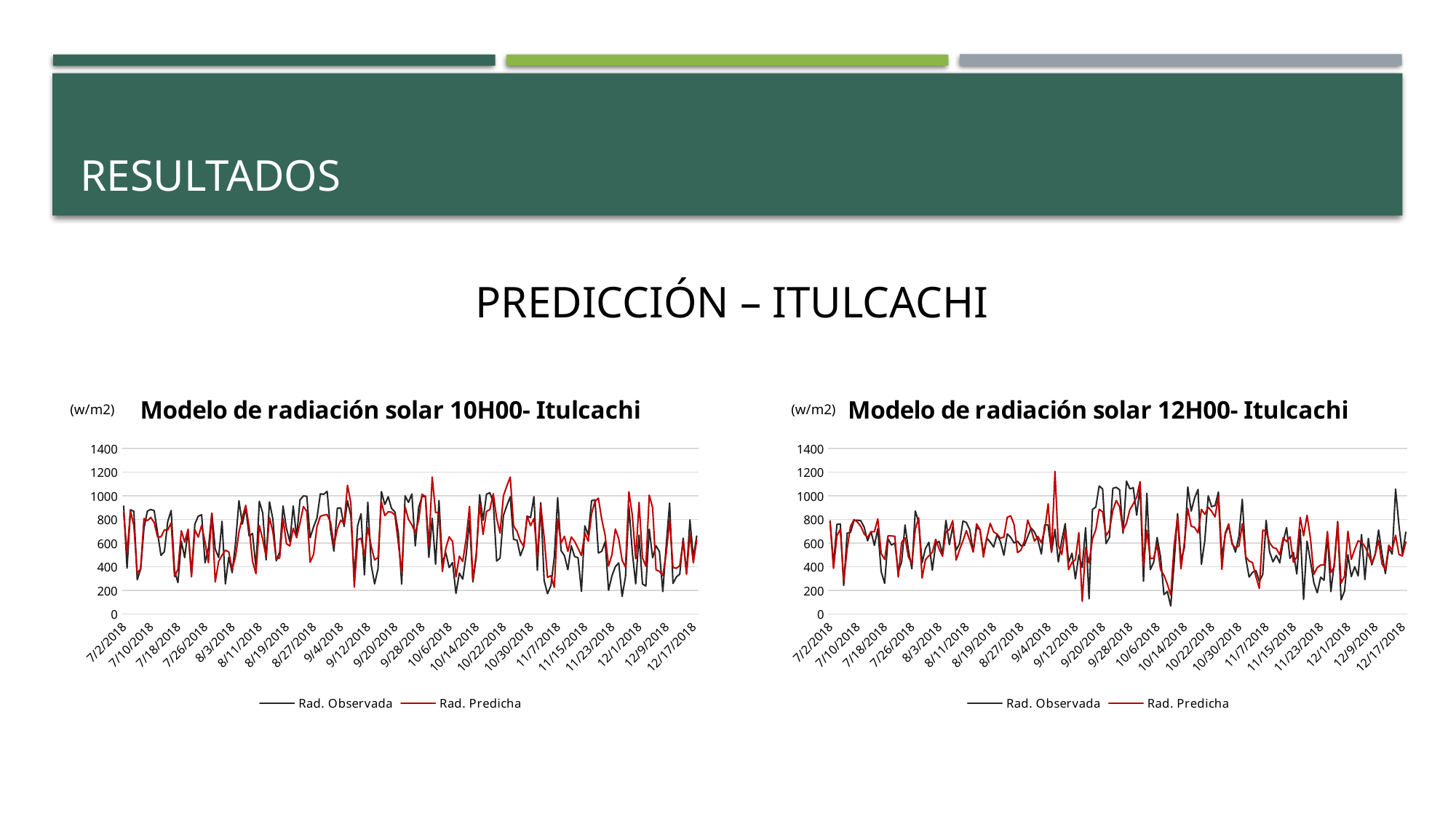
How many series does the legend of the 'Modelo de radiación solar 10H00- Itulcachi' chart list? 2 What kind of chart is the 'Modelo de radiación solar 10H00- Itulcachi' chart? line chart In the 'Modelo de radiación solar 12H00- Itulcachi' chart, which series is drawn in red? Rad. Predicha In the 'Modelo de radiación solar 12H00- Itulcachi' chart, is the highest value of Rad. Predicha greater or less than 1000? greater What kind of chart is the 'Modelo de radiación solar 12H00- Itulcachi' chart? line chart How many series does the legend of the 'Modelo de radiación solar 12H00- Itulcachi' chart list? 2 In the 'Modelo de radiación solar 10H00- Itulcachi' chart, is the highest value of Rad. Predicha greater or less than 1000? greater In the 'Modelo de radiación solar 12H00- Itulcachi' chart, is the lowest value of Rad. Observada greater or less than 200? less What unit is shown above the y axis of the 'Modelo de radiación solar 10H00- Itulcachi' chart? (w/m2)